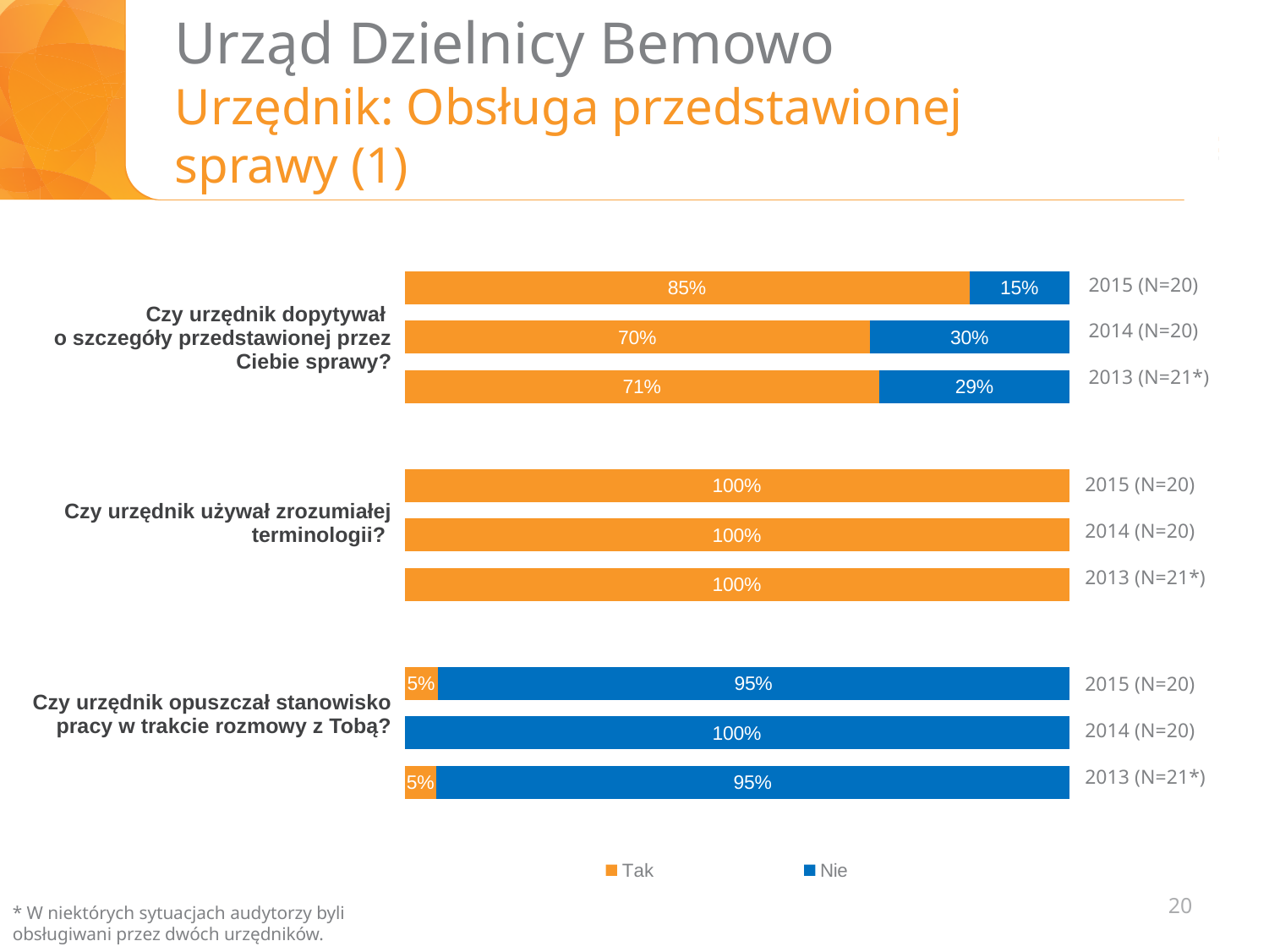
What are the two legend entries? Tak and Nie What is the 'Tak' value for 2015 (N=20) for the question 'Czy urzędnik dopytywał o szczegóły przedstawionej przez Ciebie sprawy?' 85% What is the 'Tak' value for 2014 (N=20) for the question 'Czy urzędnik używał zrozumiałej terminologii?' 100% For the question 'Czy urzędnik opuszczał stanowisko pracy w trakcie rozmowy z Tobą?', which is larger in 2014 (N=20): the 'Tak' share or the 'Nie' share? Nie For the question 'Czy urzędnik dopytywał o szczegóły przedstawionej przez Ciebie sprawy?', which year has the highest 'Tak' share? 2015 (N=20) What is the 'Nie' value for 2015 (N=20) for the question 'Czy urzędnik opuszczał stanowisko pracy w trakcie rozmowy z Tobą?' 95% What type of chart is shown on the slide? stacked bar chart What is the 'Tak' value for 2013 (N=21*) for the question 'Czy urzędnik opuszczał stanowisko pracy w trakcie rozmowy z Tobą?' 5% For the question 'Czy urzędnik dopytywał o szczegóły przedstawionej przez Ciebie sprawy?', what is the difference between the 'Tak' values for 2015 and 2014? 15 percentage points How many series does the legend list? 2 What is the 'Nie' value for 2014 (N=20) for the question 'Czy urzędnik dopytywał o szczegóły przedstawionej przez Ciebie sprawy?' 30% What is the 'Tak' value for 2013 (N=21*) for the question 'Czy urzędnik dopytywał o szczegóły przedstawionej przez Ciebie sprawy?' 71%